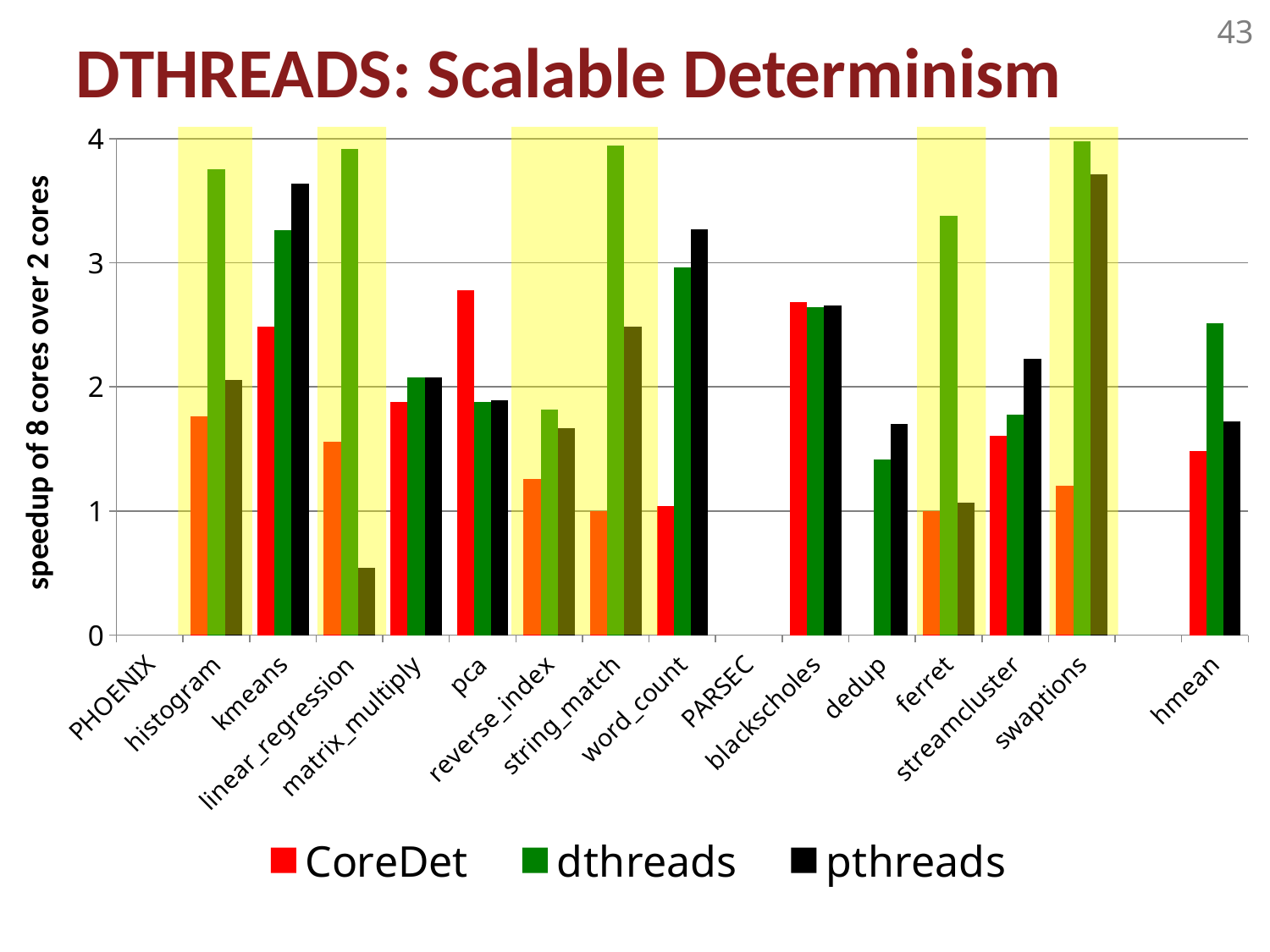
How many series does the legend list? 3 Which benchmark has the lowest pthreads value? linear_regression Which series are listed in the legend? CoreDet, dthreads, pthreads What is the y-axis title of the chart? speedup of 8 cores over 2 cores Is the dthreads value for hmean greater or less than 2? greater For streamcluster, which is larger: the dthreads value or the pthreads value? pthreads Is the pthreads value for word_count greater or less than 3? greater Is the pthreads value for linear_regression greater or less than 1? less What kind of chart is shown on the slide? bar chart For kmeans, which is larger: the dthreads value or the pthreads value? pthreads